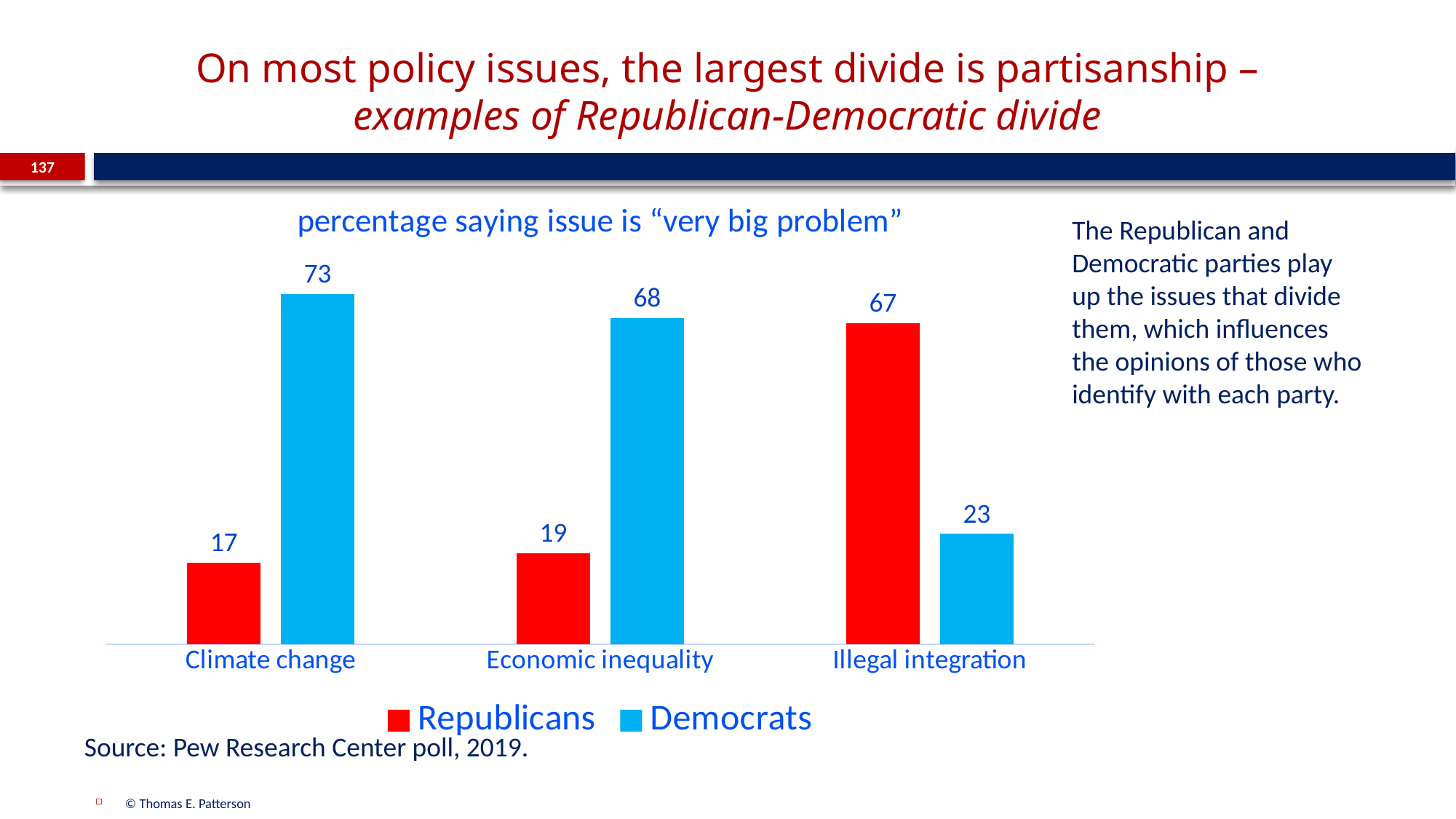
What colour represents Republicans in the chart? Red What is the difference between the Democrats' and Republicans' values for economic inequality? 49 Which issue has the highest value for Democrats? Climate change Which is larger for illegal integration, the Republicans' value or the Democrats' value? Republicans How many series does the legend list? 2 What percentage of Democrats say climate change is a very big problem? 73 Which issue has the lowest value for Republicans? Climate change What percentage of Republicans say illegal integration is a very big problem? 67 What kind of chart is shown on the slide? Bar chart What is the value for Republicans on economic inequality? 19 How many issues are shown on the x axis? 3 What is the value for Democrats on illegal integration? 23